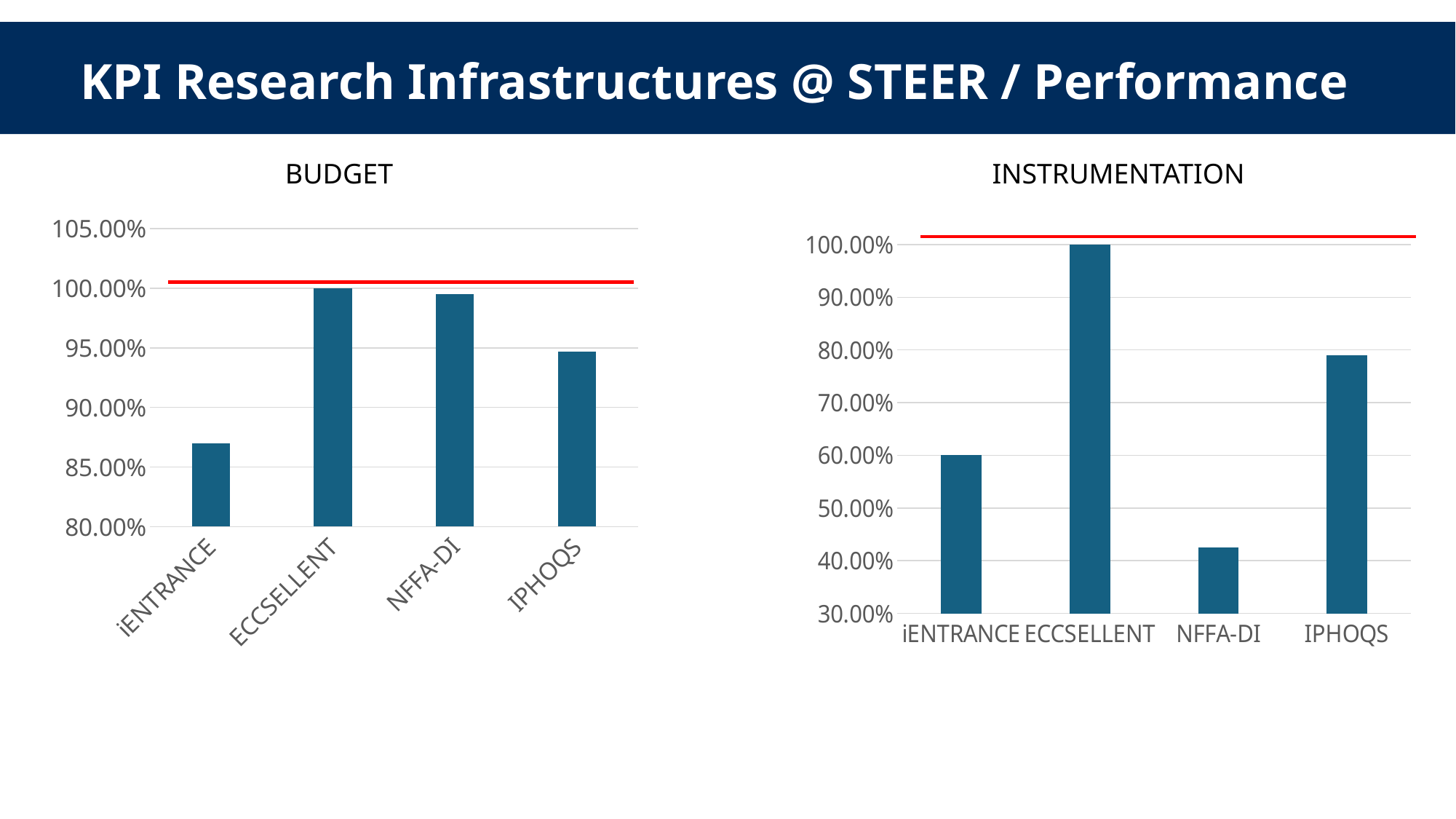
In the INSTRUMENTATION chart, is the value for NFFA-DI greater or less than 50.00%? less What type of chart is the BUDGET chart? Bar chart In the INSTRUMENTATION chart, which category has the lowest value? NFFA-DI In the BUDGET chart, is the value for iENTRANCE greater or less than 90.00%? less In the BUDGET chart, which is larger, the value for NFFA-DI or the value for IPHOQS? NFFA-DI In the INSTRUMENTATION chart, what is the value for iENTRANCE? 60.00% In the INSTRUMENTATION chart, which category has the highest value? ECCSELLENT What is the title of the chart on the right side of the slide? INSTRUMENTATION In the BUDGET chart, what is the value for ECCSELLENT? 100.00% In the BUDGET chart, which category has the lowest value? iENTRANCE How many categories are shown in the INSTRUMENTATION chart? 4 In the INSTRUMENTATION chart, what is the value for ECCSELLENT? 100.00%